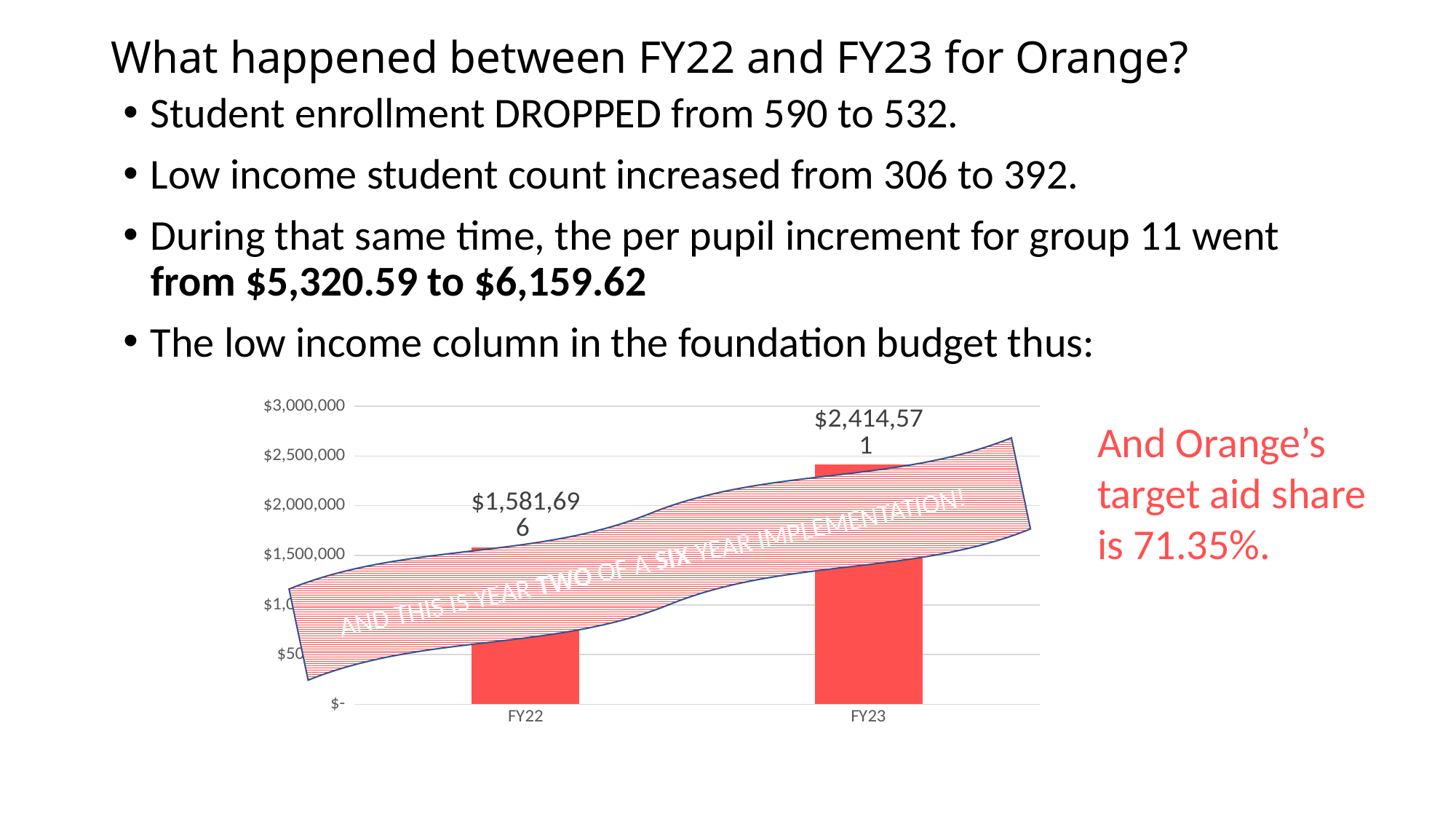
What is the value of the FY23 bar in the chart? $2,414,571 What is the highest value shown on the chart's vertical axis? $3,000,000 What is the difference between the FY23 and FY22 values in the chart? $832,875 Is the value for FY23 greater or less than $2,000,000? greater Which fiscal year has the lower bar in the chart? FY22 Which fiscal year has the higher bar in the chart? FY23 How many bars are plotted in the chart? 2 Is the value for FY22 greater or less than $2,000,000? less Do the values rise or fall from FY22 to FY23? rise What kind of chart is shown on the slide? bar chart Is the FY22 value larger or smaller than the FY23 value? smaller What is the value of the FY22 bar in the chart? $1,581,696